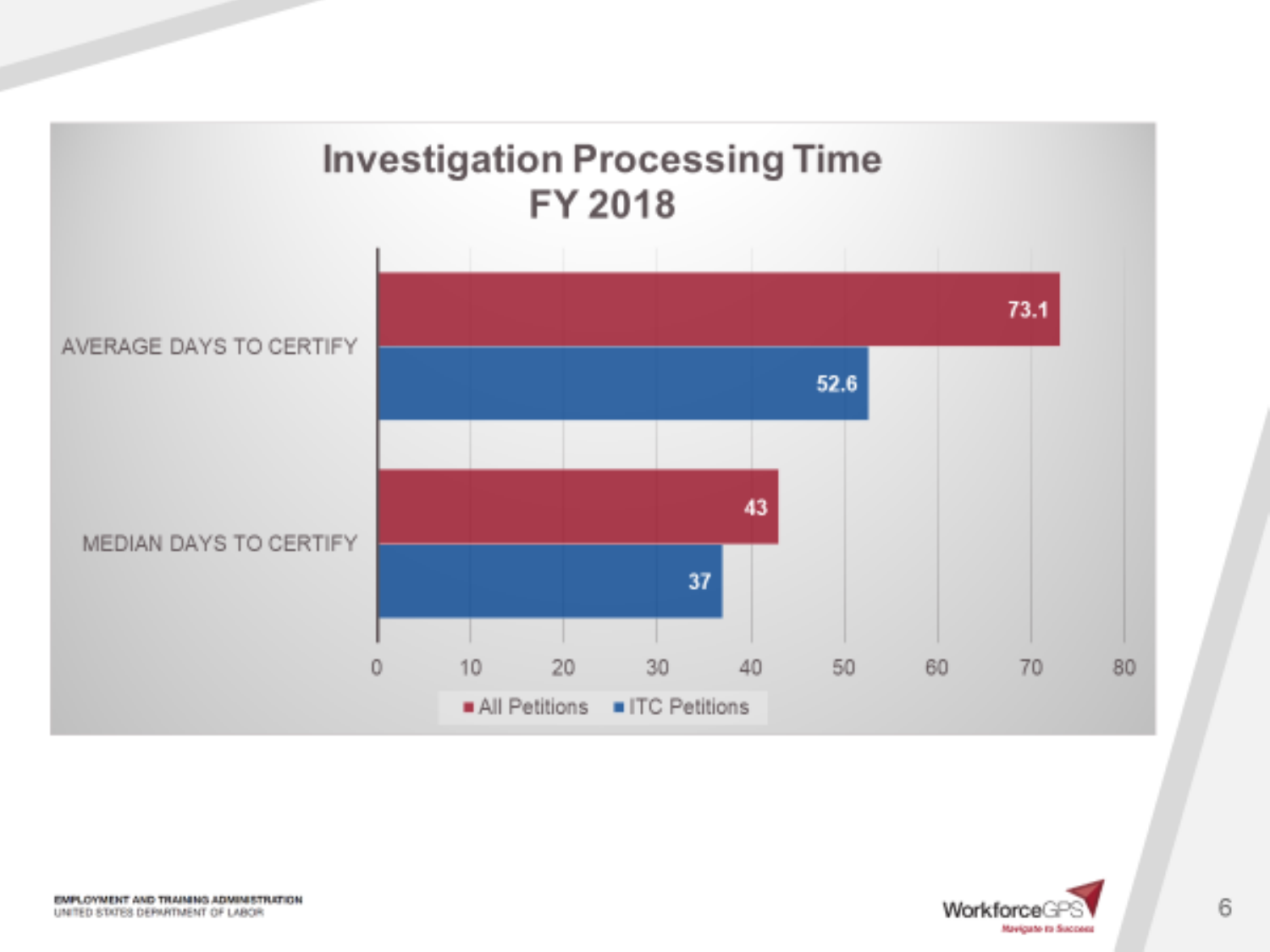
What is the value for All Petitions for Median Days to Certify? 43 Which is larger for Median Days to Certify: All Petitions or ITC Petitions? All Petitions What is the value for ITC Petitions for Average Days to Certify? 52.6 What is the value for ITC Petitions for Median Days to Certify? 37 What kind of chart is shown on the slide? Bar chart What is the difference between All Petitions and ITC Petitions for Average Days to Certify? 20.5 Which bar has the lowest value on the chart? ITC Petitions, Median Days to Certify What is the value for All Petitions for Average Days to Certify? 73.1 Which bar has the highest value on the chart? All Petitions, Average Days to Certify How many series does the legend list? 2 What is the difference between All Petitions and ITC Petitions for Median Days to Certify? 6 What is the title of the chart? Investigation Processing Time FY 2018